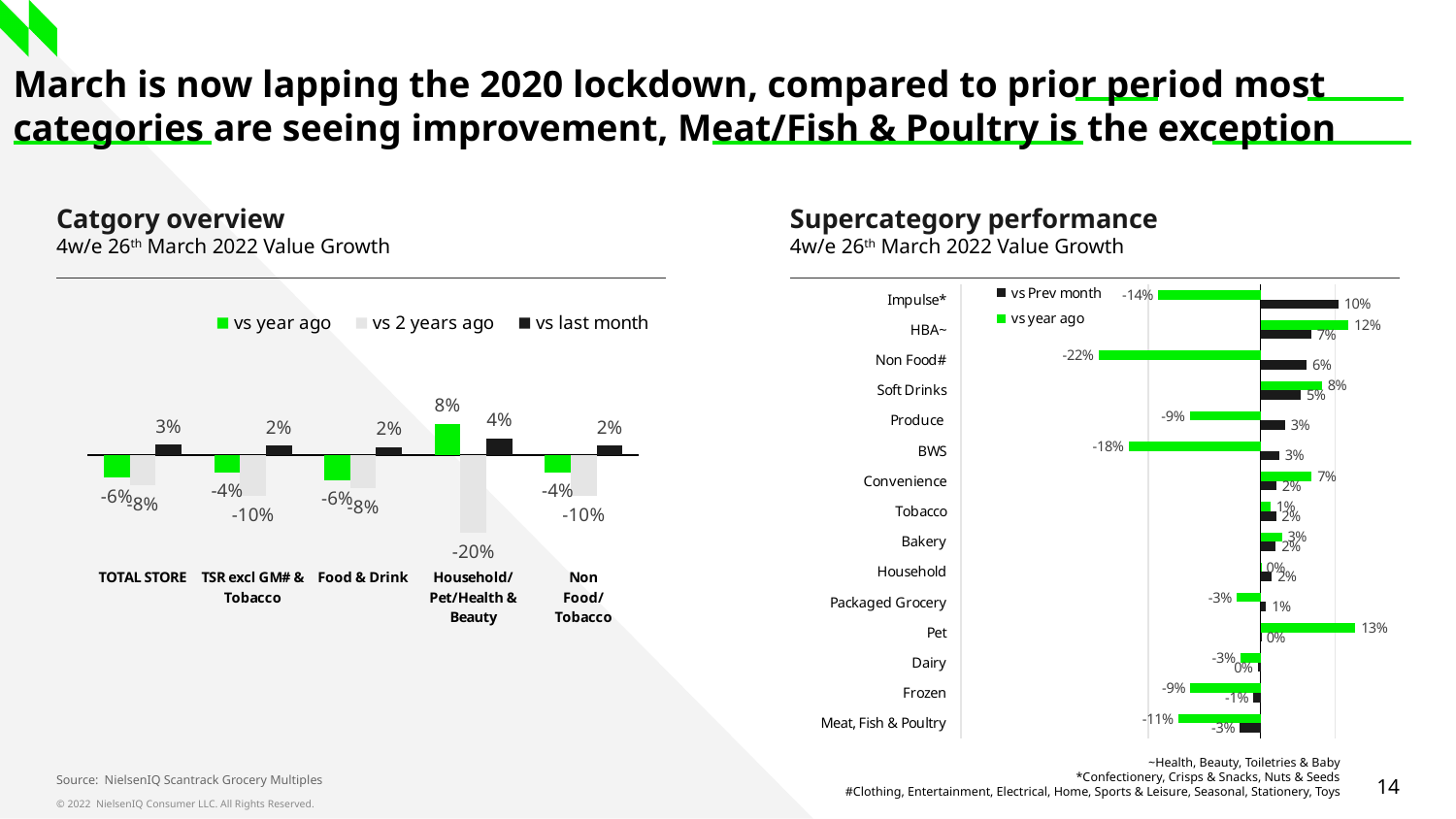
In the Catgory overview chart, how many series does the legend list? 3 In the Supercategory performance chart, which category has the highest vs year ago value? Pet In the Supercategory performance chart, which is larger: the vs Prev month value for Impulse* or for HBA~? Impulse* In the Supercategory performance chart, how many categories are plotted? 15 In the Catgory overview chart, what is the vs last month value for TOTAL STORE? 3% In the Supercategory performance chart, what is the vs year ago value for Non Food#? -22% In the Supercategory performance chart, what is the vs Prev month value for Meat, Fish & Poultry? -3% What type of chart is the Supercategory performance chart? Bar chart In the Catgory overview chart, what is the difference between the vs year ago and vs 2 years ago values for TSR excl GM# & Tobacco? 6 percentage points In the Catgory overview chart, which category has the highest vs year ago value? Household/Pet/Health & Beauty In the Supercategory performance chart, which category has the lowest vs Prev month value? Meat, Fish & Poultry In the Catgory overview chart, what is the vs 2 years ago value for Household/Pet/Health & Beauty? -20%